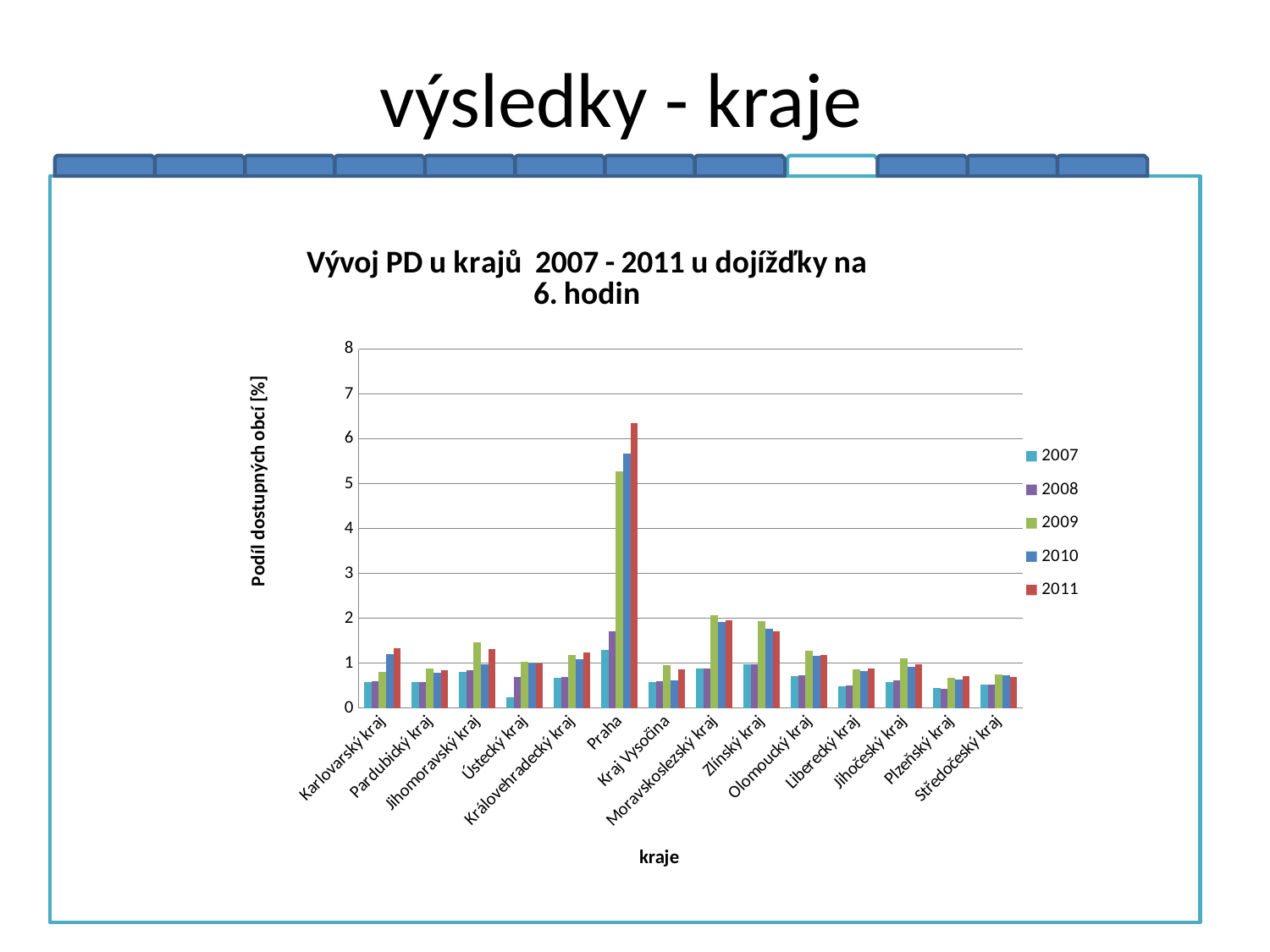
Which region has the highest value for 2011? Praha Do the values for Praha rise or fall from 2007 to 2011? rise Is the value for Praha in 2009 greater or less than 5? greater Is the value for Praha in 2011 greater or less than 6? greater What kind of chart is shown on the slide? bar chart Is the value for Ústecký kraj in 2007 greater or less than 1? less Which is larger for 2011: Praha or Zlínský kraj? Praha What is the label of the vertical axis? Podíl dostupných obcí [%] How many series does the legend list? 5 How many regions (kraje) are shown on the x axis? 14 What is the title of the chart? Vývoj PD u krajů 2007 - 2011 u dojížďky na 6. hodin